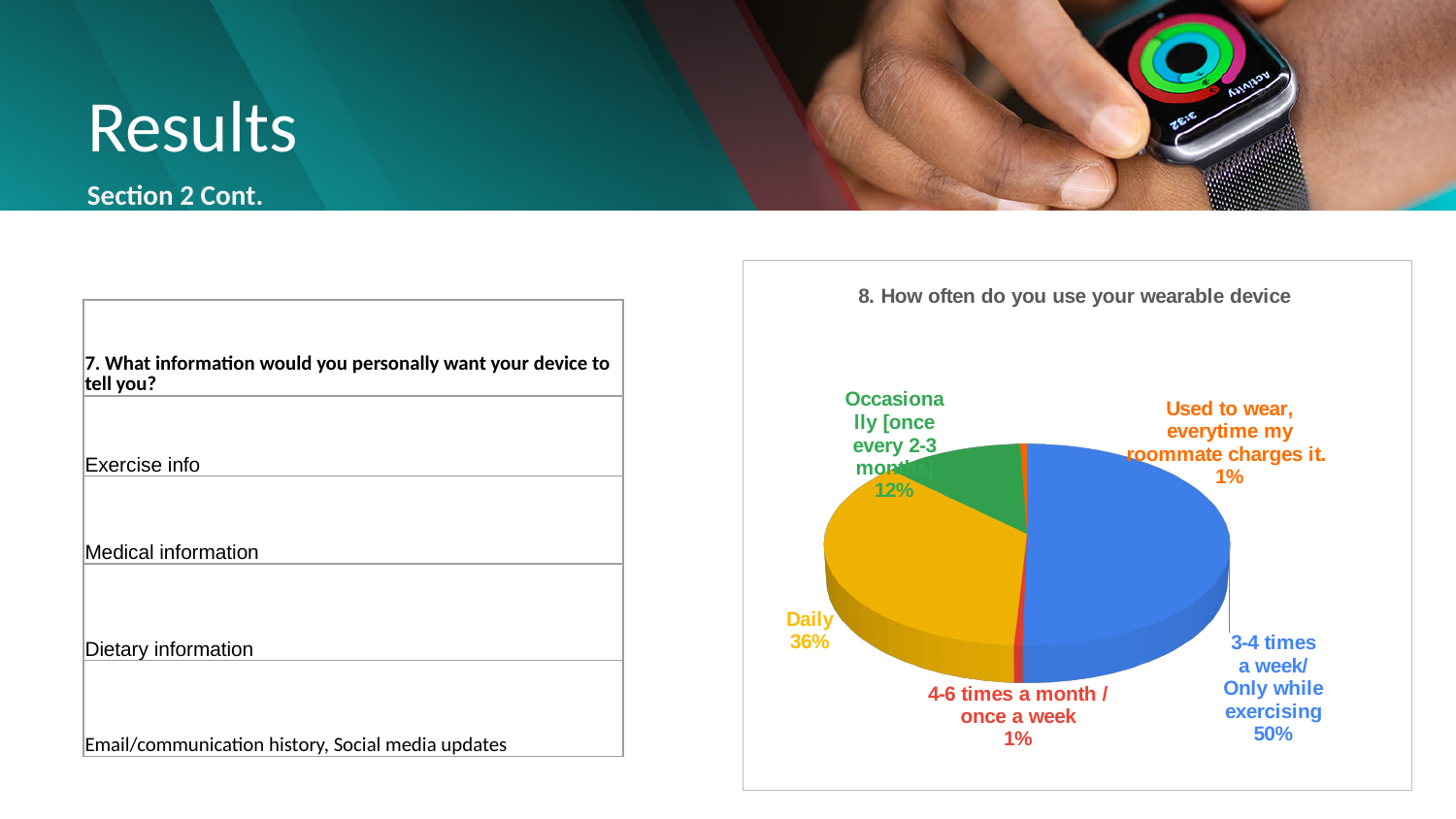
What share of the pie is labelled "4-6 times a month / once a week"? 1% What share of the pie is labelled "Daily"? 36% What is the difference in percentage points between the "3-4 times a week/ Only while exercising" slice and the "Daily" slice? 14 Which slice is larger, "Daily" or "Occasionally [once every 2-3 months]"? Daily How many slices does the pie chart have? 5 What share of the pie is labelled "Occasionally [once every 2-3 months]"? 12% Which category has the largest slice of the pie? 3-4 times a week/ Only while exercising What is the combined share of the "Daily" and "Occasionally [once every 2-3 months]" slices? 48% What is the title of the chart on the slide? 8. How often do you use your wearable device What kind of chart is shown on the slide? Pie chart What colour is the "Daily" slice of the pie? Yellow